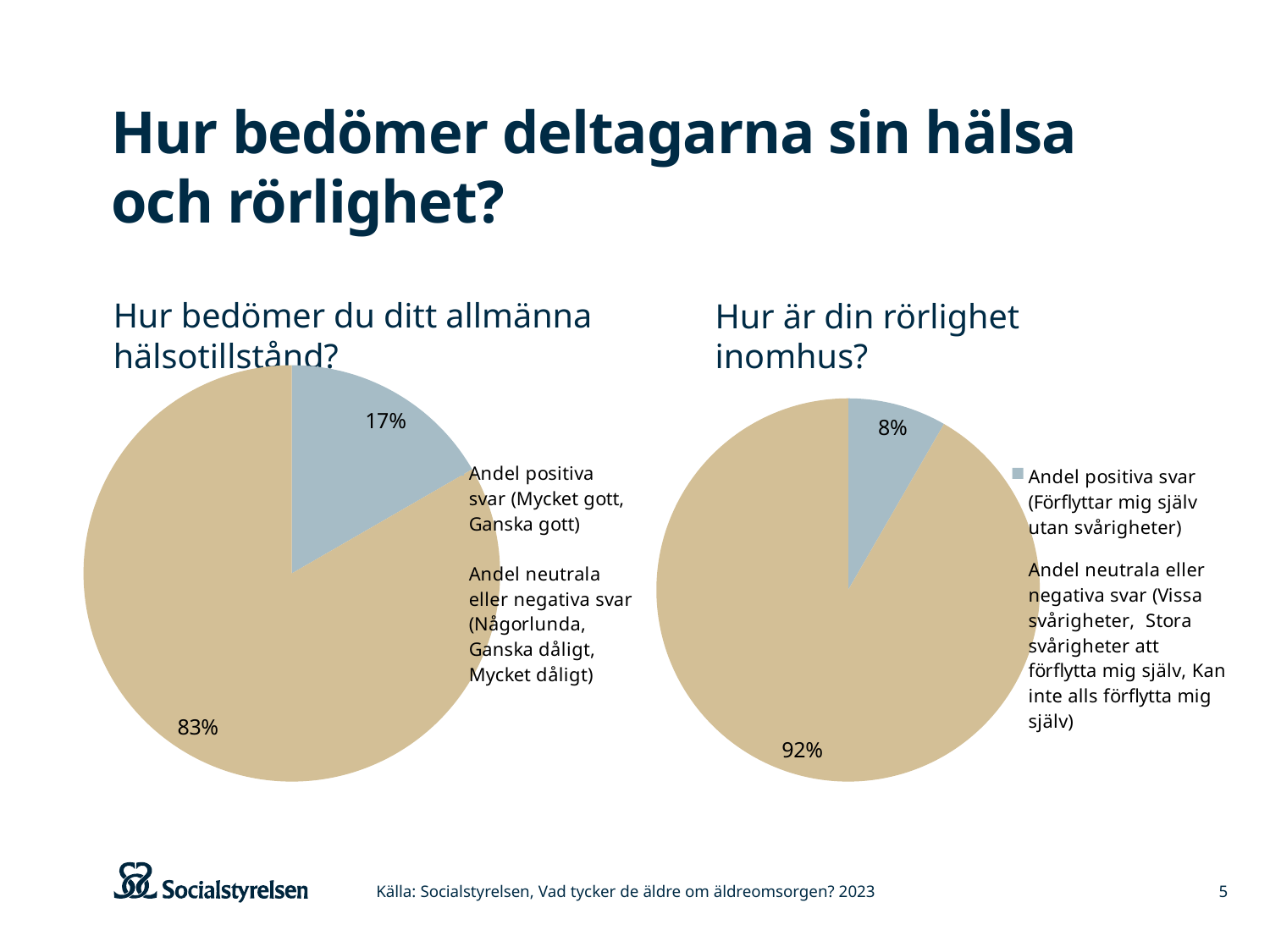
In the right pie chart (Hur är din rörlighet inomhus?), what share is labelled for the positive answers (Andel positiva svar)? 8% How many charts are shown on the slide? 2 In the left pie chart (Hur bedömer du ditt allmänna hälsotillstånd?), what is the difference in percentage points between the neutral/negative share and the positive share? 66 percentage points In the left pie chart (Hur bedömer du ditt allmänna hälsotillstånd?), which slice is the largest? Andel neutrala eller negativa svar In the right pie chart (Hur är din rörlighet inomhus?), which slice is the smallest? Andel positiva svar In the left pie chart (Hur bedömer du ditt allmänna hälsotillstånd?), what share is labelled for the positive answers (Andel positiva svar)? 17% How many slices does the right pie chart (Hur är din rörlighet inomhus?) have? 2 What type of chart is used for 'Hur bedömer du ditt allmänna hälsotillstånd?'? Pie chart In the right pie chart (Hur är din rörlighet inomhus?), what share is labelled for the neutral or negative answers (Andel neutrala eller negativa svar)? 92% In the right pie chart (Hur är din rörlighet inomhus?), what is the difference in percentage points between the neutral/negative share and the positive share? 84 percentage points Which chart shows a larger share of positive answers: the left chart (allmänna hälsotillstånd) or the right chart (rörlighet inomhus)? The left chart (allmänna hälsotillstånd) In the left pie chart (Hur bedömer du ditt allmänna hälsotillstånd?), what share is labelled for the neutral or negative answers (Andel neutrala eller negativa svar)? 83%